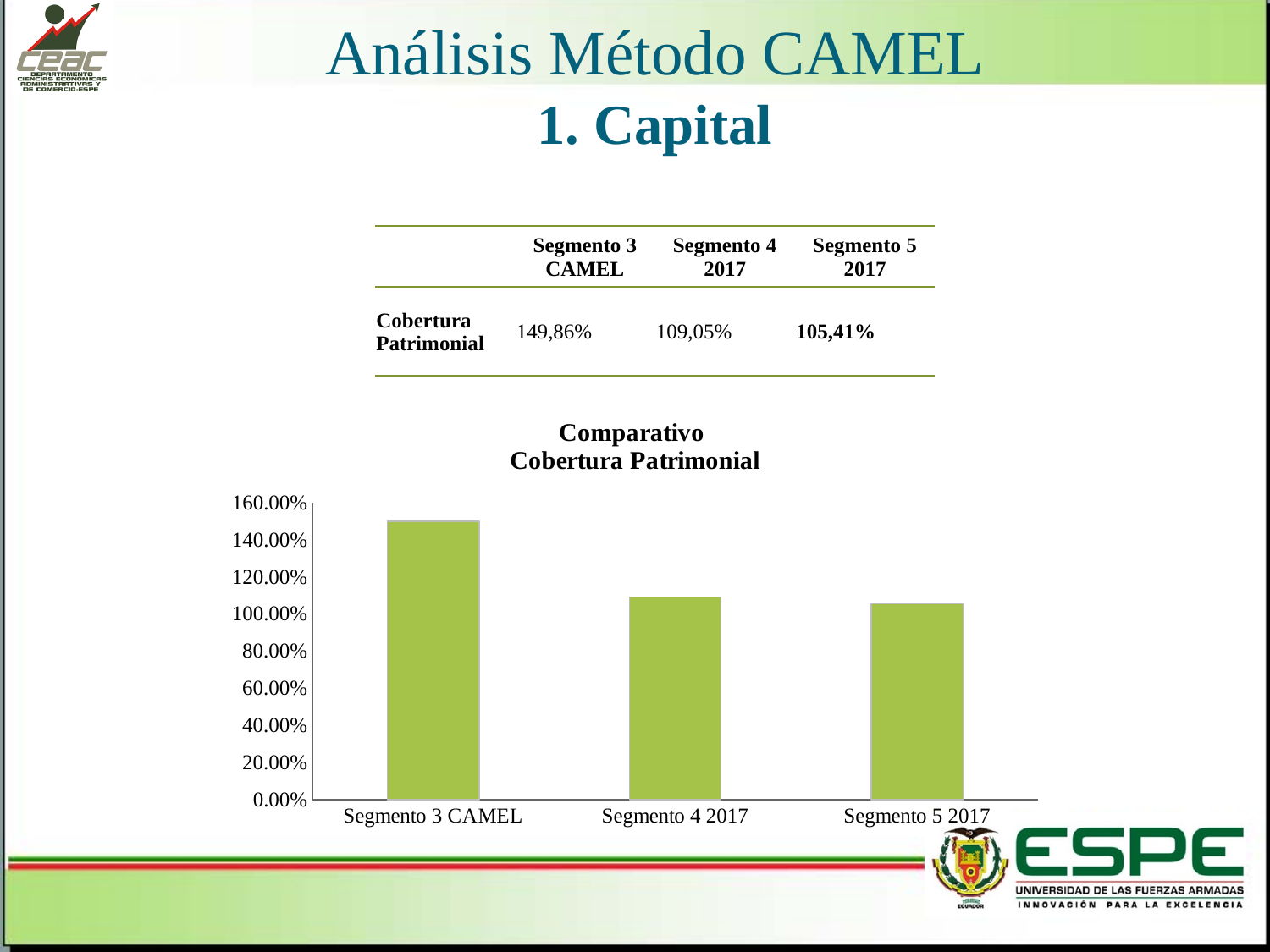
Which category has the highest bar in the 'Comparativo Cobertura Patrimonial' chart? Segmento 3 CAMEL Do the bars rise or fall from left to right across the 'Comparativo Cobertura Patrimonial' chart? fall How many categories are plotted in the 'Comparativo Cobertura Patrimonial' chart? 3 What is the Cobertura Patrimonial value for Segmento 5 2017? 105,41% Is the bar for Segmento 3 CAMEL greater or less than 140.00%? greater What is the difference between the Cobertura Patrimonial of Segmento 3 CAMEL and Segmento 4 2017? 40,81% What is the Cobertura Patrimonial value for Segmento 3 CAMEL? 149,86% What type of chart is shown under the title 'Comparativo Cobertura Patrimonial'? bar chart Is the bar for Segmento 5 2017 greater or less than 120.00%? less Which category has the lowest bar in the 'Comparativo Cobertura Patrimonial' chart? Segmento 5 2017 What is the title of the bar chart on the slide? Comparativo Cobertura Patrimonial What is the Cobertura Patrimonial value for Segmento 4 2017? 109,05%